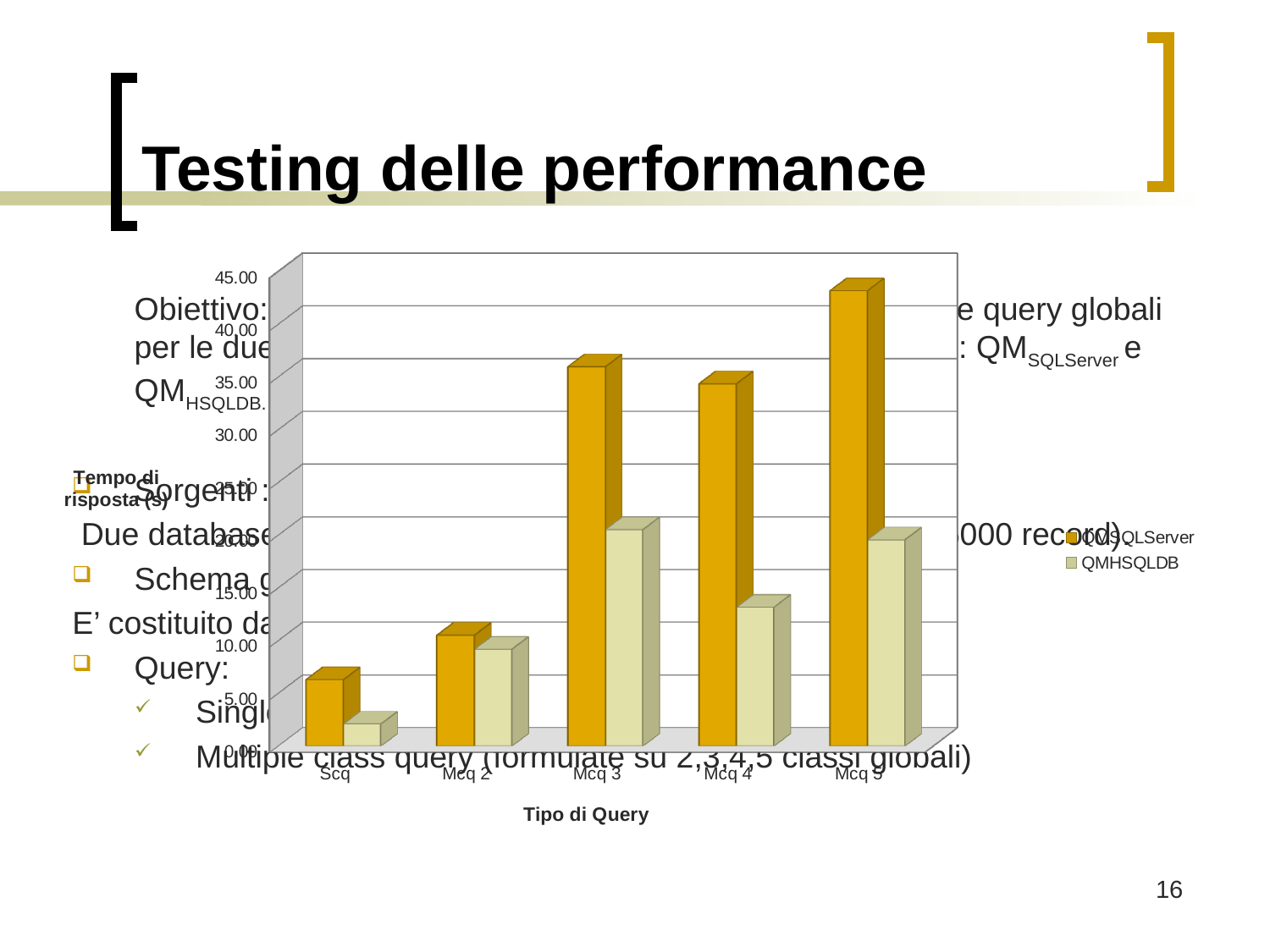
What kind of chart is shown on the slide? bar chart Is the QMHSQLDB value for Scq greater or less than 5.00? less Is the QMSQLServer value for Mcq 3 greater or less than 30.00? greater Which query type has the lowest value for the QMHSQLDB series? Scq For the QMHSQLDB series, which is larger, the value for Mcq 3 or the value for Mcq 4? Mcq 3 Is the QMSQLServer value for Mcq 5 greater or less than 40.00? greater What is the title of the x axis of the chart? Tipo di Query Which query type has the lowest value for the QMSQLServer series? Scq For Mcq 3, which series has the larger value, QMSQLServer or QMHSQLDB? QMSQLServer Which query type has the highest value for the QMSQLServer series? Mcq 5 How many query types are shown on the x axis of the chart? 5 How many series does the chart legend list? 2